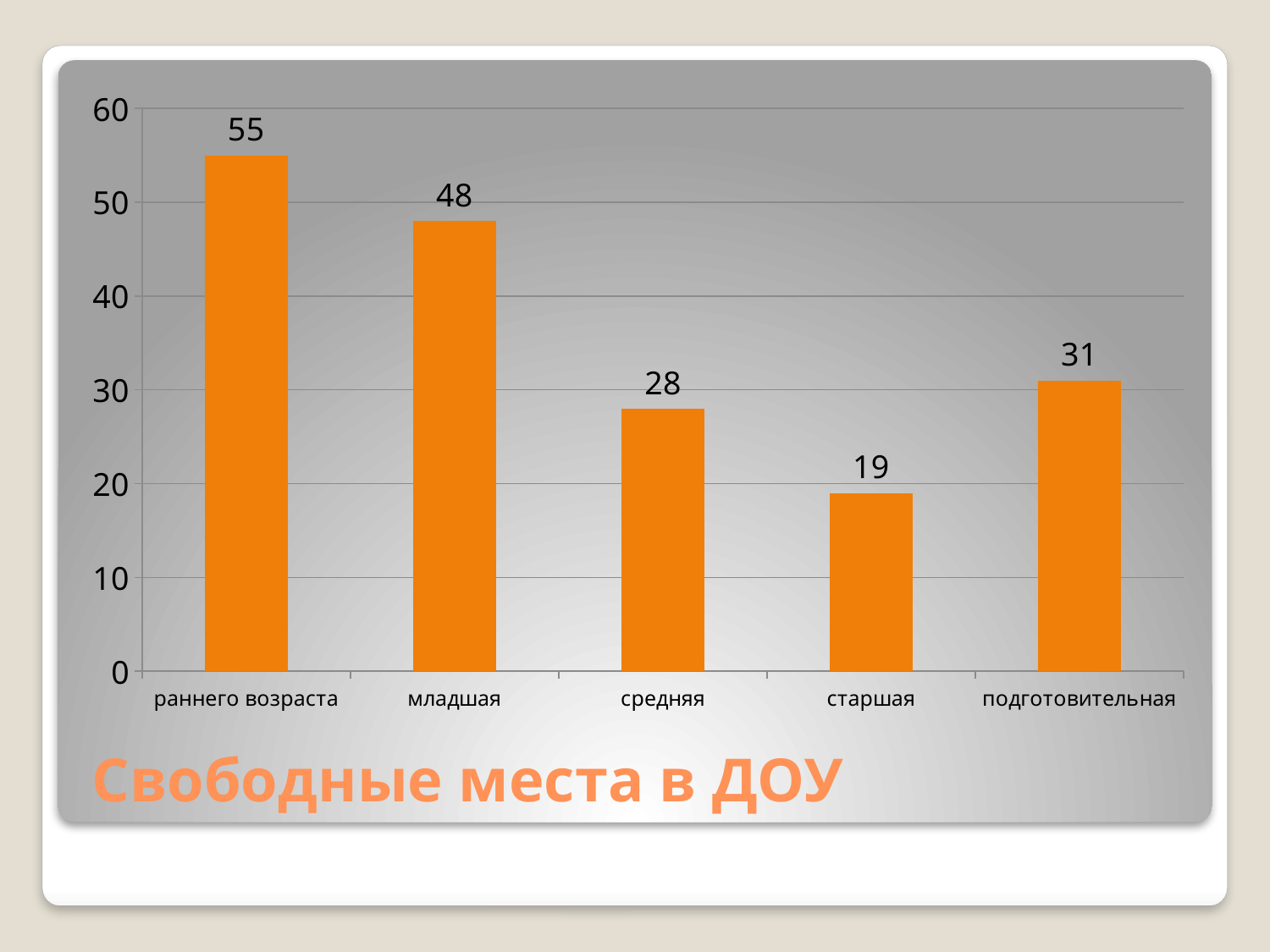
What is the difference between the values for раннего возраста and младшая? 7 What is the value for младшая? 48 What is the value for подготовительная? 31 What is the value for раннего возраста? 55 What is the title of the chart? Свободные места в ДОУ What is the value for старшая? 19 What is the value for средняя? 28 Which category has the lowest value? старшая Which is larger, the value for средняя or the value for подготовительная? подготовительная Which category has the highest value? раннего возраста How many categories are shown on the chart? 5 What kind of chart is shown on the slide? bar chart